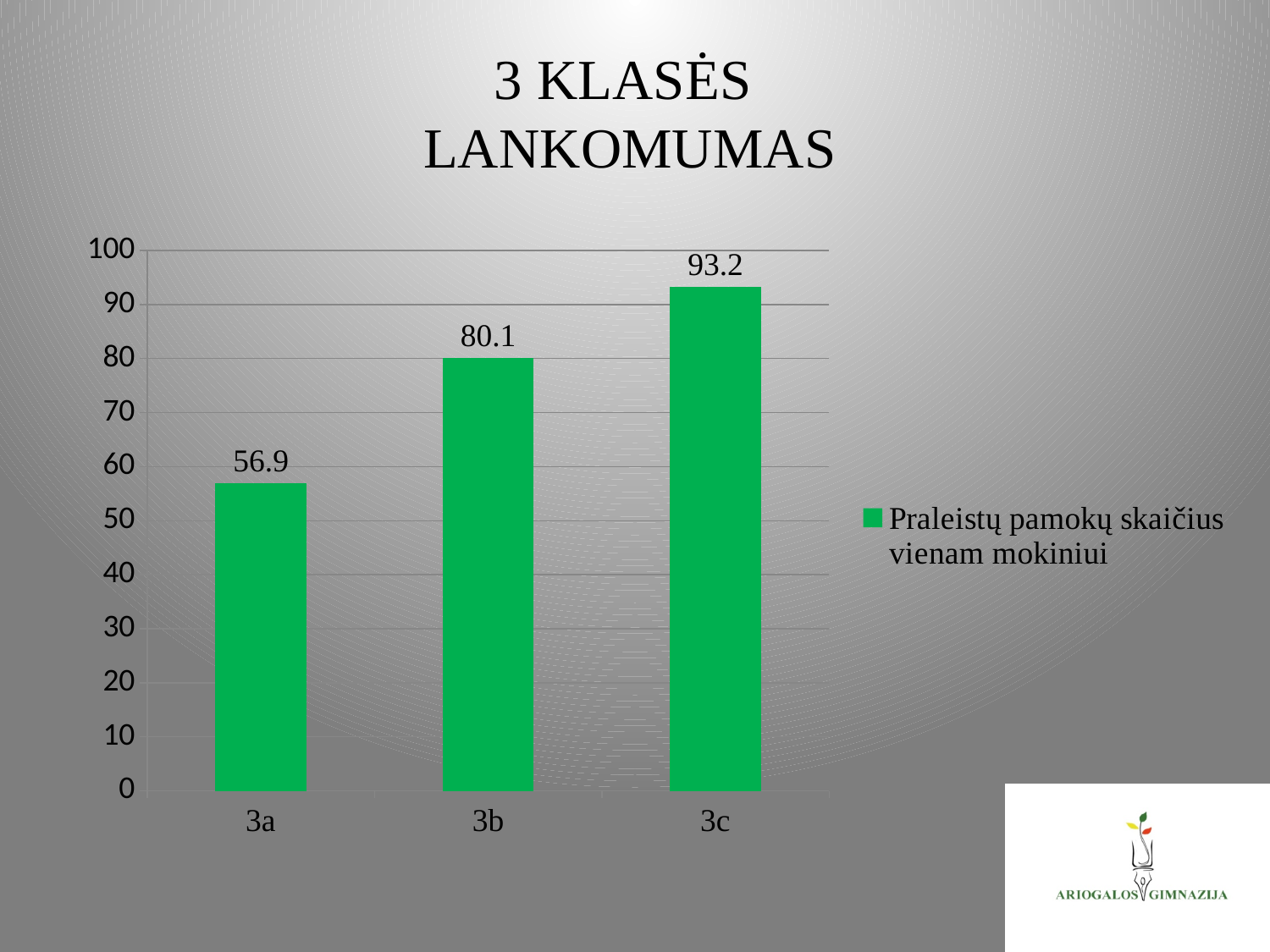
Which class has the lowest value? 3a What is the difference between the values for 3c and 3a? 36.3 Which class has the highest value? 3c What is the difference between the values for 3b and 3a? 23.2 How many classes are shown on the chart? 3 What kind of chart is shown on the slide? bar chart What is the value for 3a? 56.9 What is the value for 3b? 80.1 Do the values rise or fall from 3a to 3c? rise How many series does the legend list? 1 What is the value for 3c? 93.2 Which is larger, the value for 3b or the value for 3c? 3c